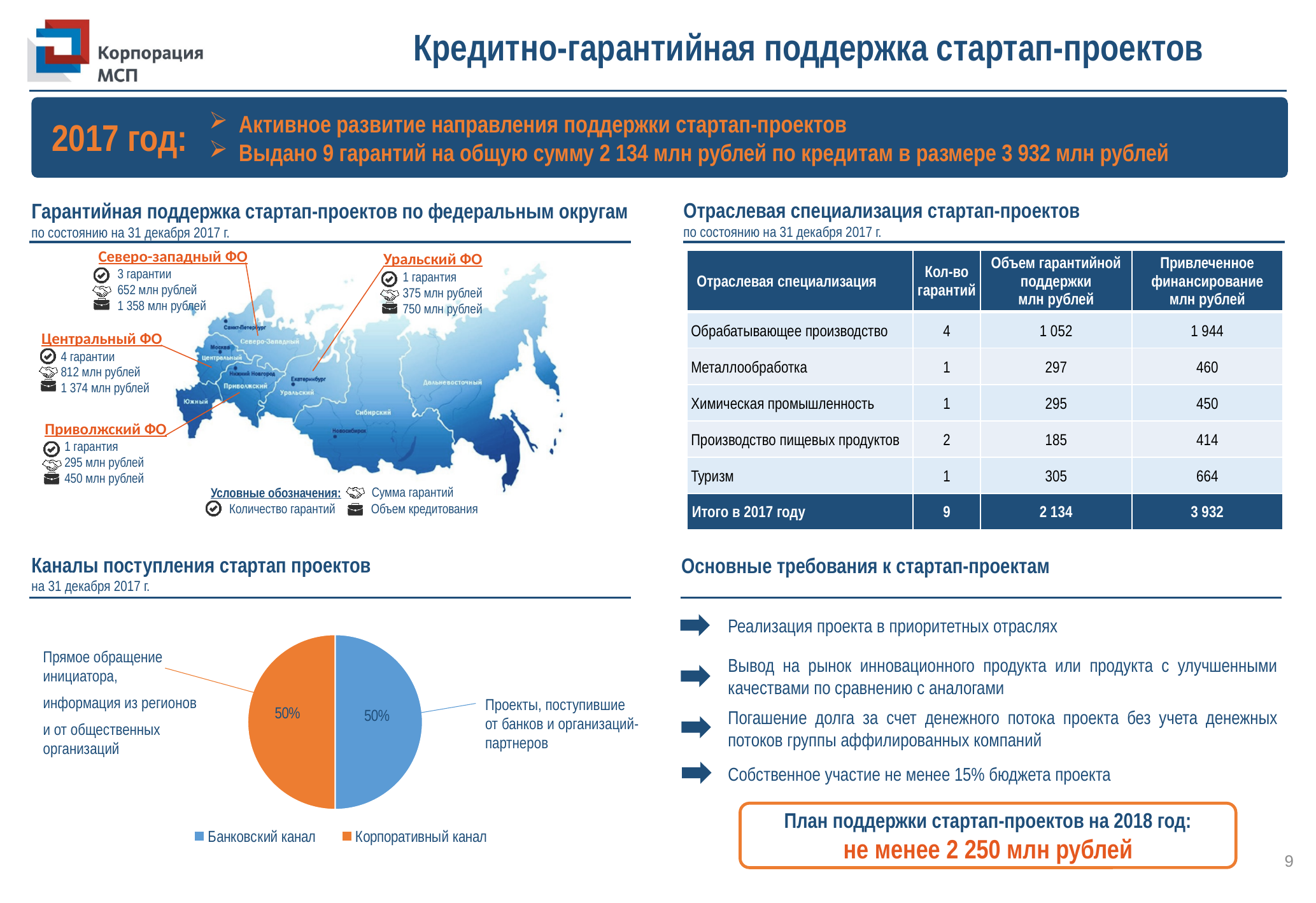
In the pie chart "Каналы поступления стартап проектов", is the share of "Банковский канал" larger than, smaller than, or equal to the share of "Корпоративный канал"? equal What colour is the "Банковский канал" slice in the pie chart "Каналы поступления стартап проектов"? blue In the pie chart "Каналы поступления стартап проектов", what is the difference between the shares of "Банковский канал" and "Корпоративный канал"? 0% What kind of chart is shown under the heading "Каналы поступления стартап проектов"? pie chart In the pie chart "Каналы поступления стартап проектов", what share does "Банковский канал" have? 50% In the pie chart "Каналы поступления стартап проектов", what share does "Корпоративный канал" have? 50% How many slices does the pie chart "Каналы поступления стартап проектов" have? 2 What is the total of the two shares shown in the pie chart "Каналы поступления стартап проектов"? 100% What colour is the "Корпоративный канал" slice in the pie chart "Каналы поступления стартап проектов"? orange How many entries does the legend of the pie chart "Каналы поступления стартап проектов" list? 2